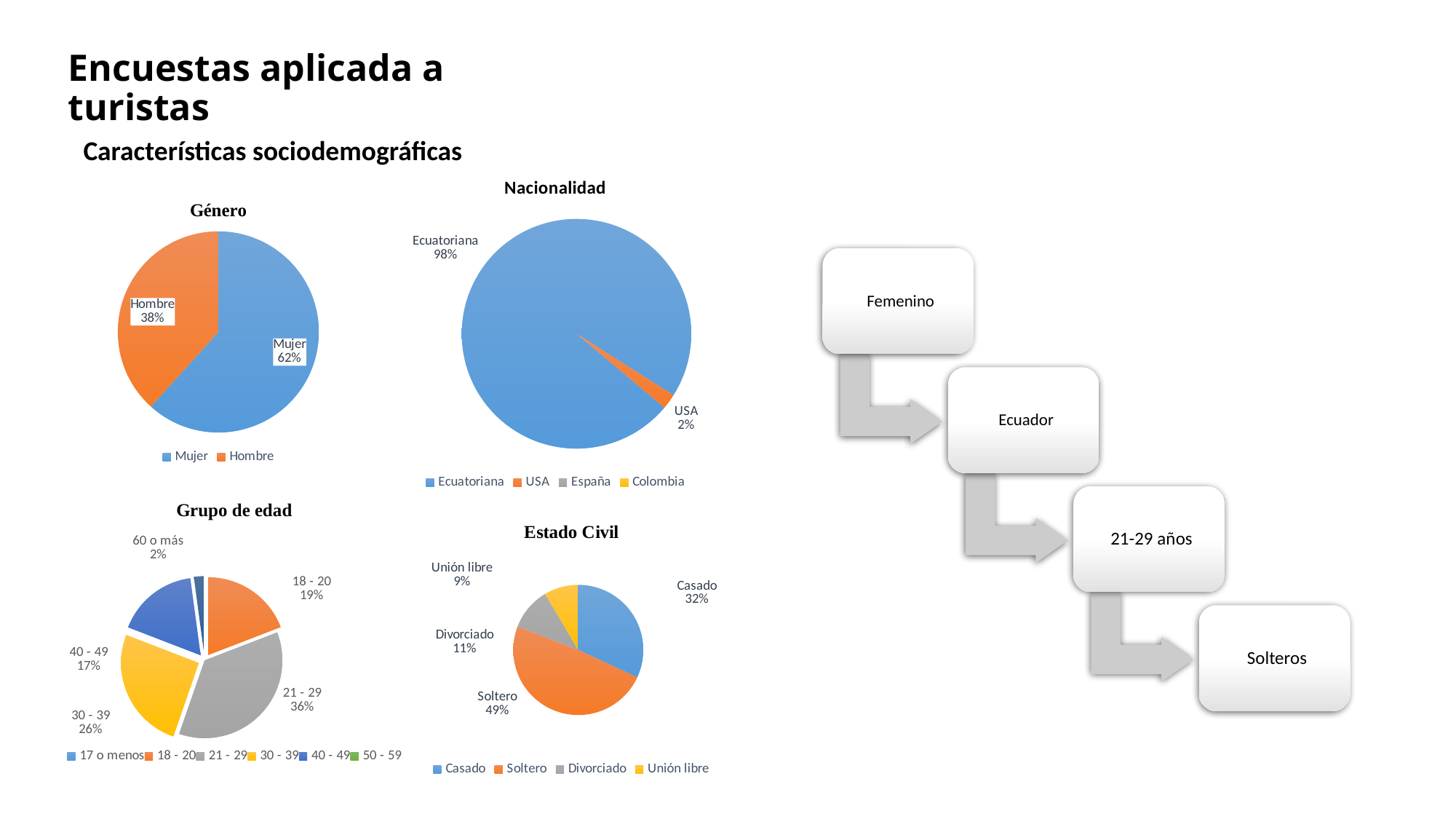
In the Grupo de edad chart, which labelled age group has the smallest share? 60 o más In the Estado Civil chart, what share is Soltero? 49% In the Nacionalidad chart, which nationality has the largest share? Ecuatoriana How many entries does the legend of the Nacionalidad chart list? 4 In the Género chart, what share of respondents are Mujer? 62% What kind of chart is the Género chart? Pie chart In the Grupo de edad chart, which is larger, the 30 - 39 share or the 40 - 49 share? 30 - 39 In the Nacionalidad chart, what share is labelled USA? 2% In the Género chart, what is the difference between the Mujer and Hombre shares? 24% In the Estado Civil chart, which category has the smallest share? Unión libre In the Estado Civil chart, what is the difference between the Casado and Divorciado shares? 21% In the Grupo de edad chart, what share is the 21 - 29 group? 36%